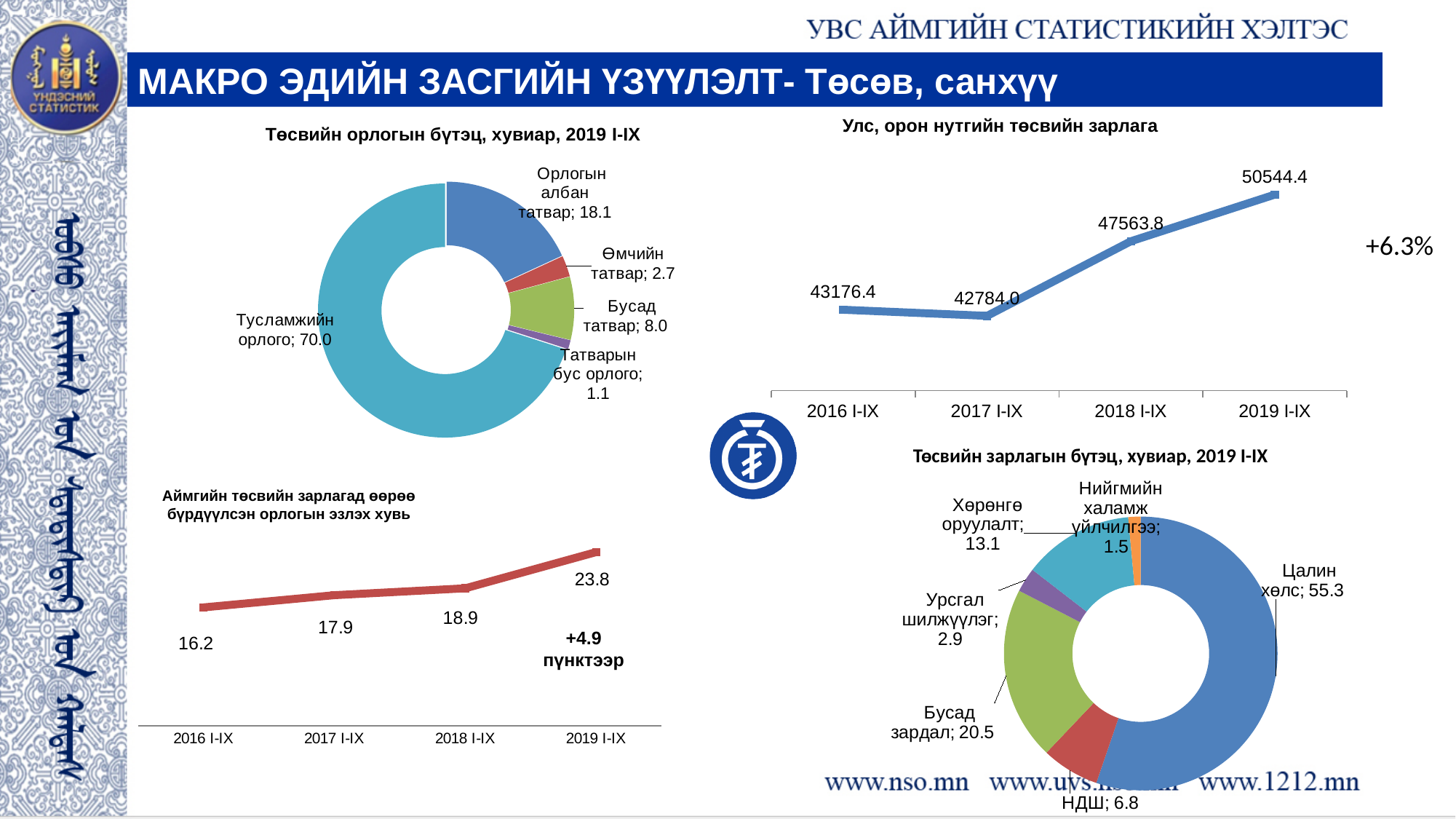
In the chart titled 'Төсвийн орлогын бүтэц, хувиар, 2019 I-IX', what is the value for Тусламжийн орлого? 70.0 In the chart titled 'Улс, орон нутгийн төсвийн зарлага', what is the value for 2019 I-IX? 50544.4 In the chart titled 'Улс, орон нутгийн төсвийн зарлага', what is the difference between the 2019 I-IX and 2018 I-IX values? 2980.6 What type of chart is 'Улс, орон нутгийн төсвийн зарлага'? line chart In the chart titled 'Улс, орон нутгийн төсвийн зарлага', which period has the lowest value? 2017 I-IX In the chart titled 'Төсвийн зарлагын бүтэц, хувиар, 2019 I-IX', what is the value for Бусад зардал? 20.5 In the chart titled 'Аймгийн төсвийн зарлагад өөрөө бүрдүүлсэн орлогын эзлэх хувь', do the values rise or fall from 2016 I-IX to 2019 I-IX? rise In the chart titled 'Аймгийн төсвийн зарлагад өөрөө бүрдүүлсэн орлогын эзлэх хувь', what is the value for 2018 I-IX? 18.9 In the chart titled 'Аймгийн төсвийн зарлагад өөрөө бүрдүүлсэн орлогын эзлэх хувь', what is the difference between the 2019 I-IX and 2016 I-IX values? 7.6 In the chart titled 'Төсвийн зарлагын бүтэц, хувиар, 2019 I-IX', which is larger: Хөрөнгө оруулалт or НДШ? Хөрөнгө оруулалт In the chart titled 'Төсвийн орлогын бүтэц, хувиар, 2019 I-IX', which category has the smallest share? Татварын бус орлого In the chart titled 'Төсвийн орлогын бүтэц, хувиар, 2019 I-IX', how many categories are shown? 5